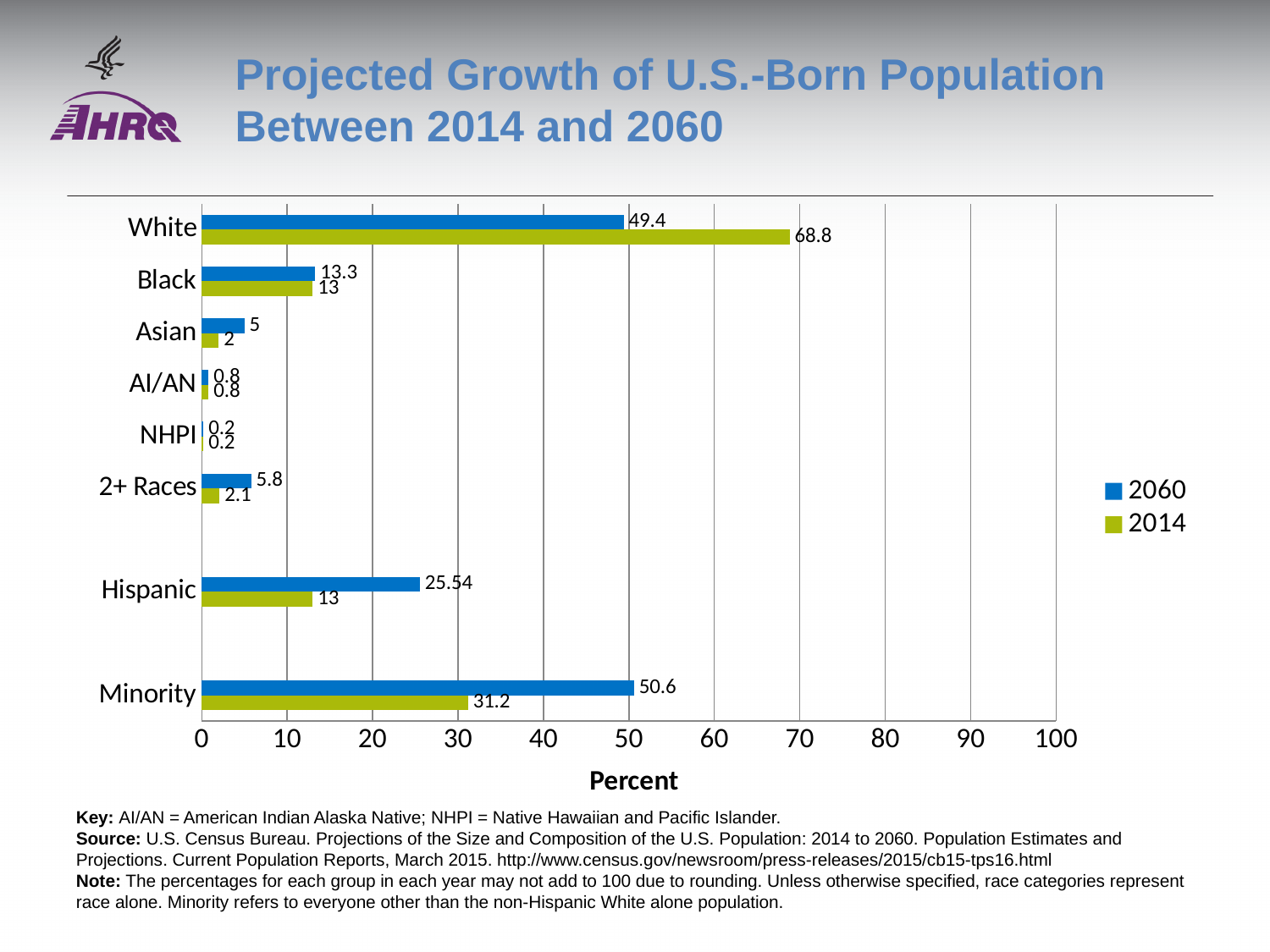
Which category has the highest 2014 value? White What is the difference between the 2014 and 2060 values for White? 19.4 What is the 2060 value for Minority? 50.6 What is the 2014 value for 2+ Races? 2.1 What is the 2014 value for Hispanic? 13 How many categories are shown on the chart? 8 Which is larger for Asian: the 2060 value or the 2014 value? 2060 How many series does the legend list? 2 What kind of chart is shown on the slide? bar chart Which category has the lowest 2060 value? NHPI What is the 2060 value for White? 49.4 Is the 2014 value for Minority greater or less than 40? less